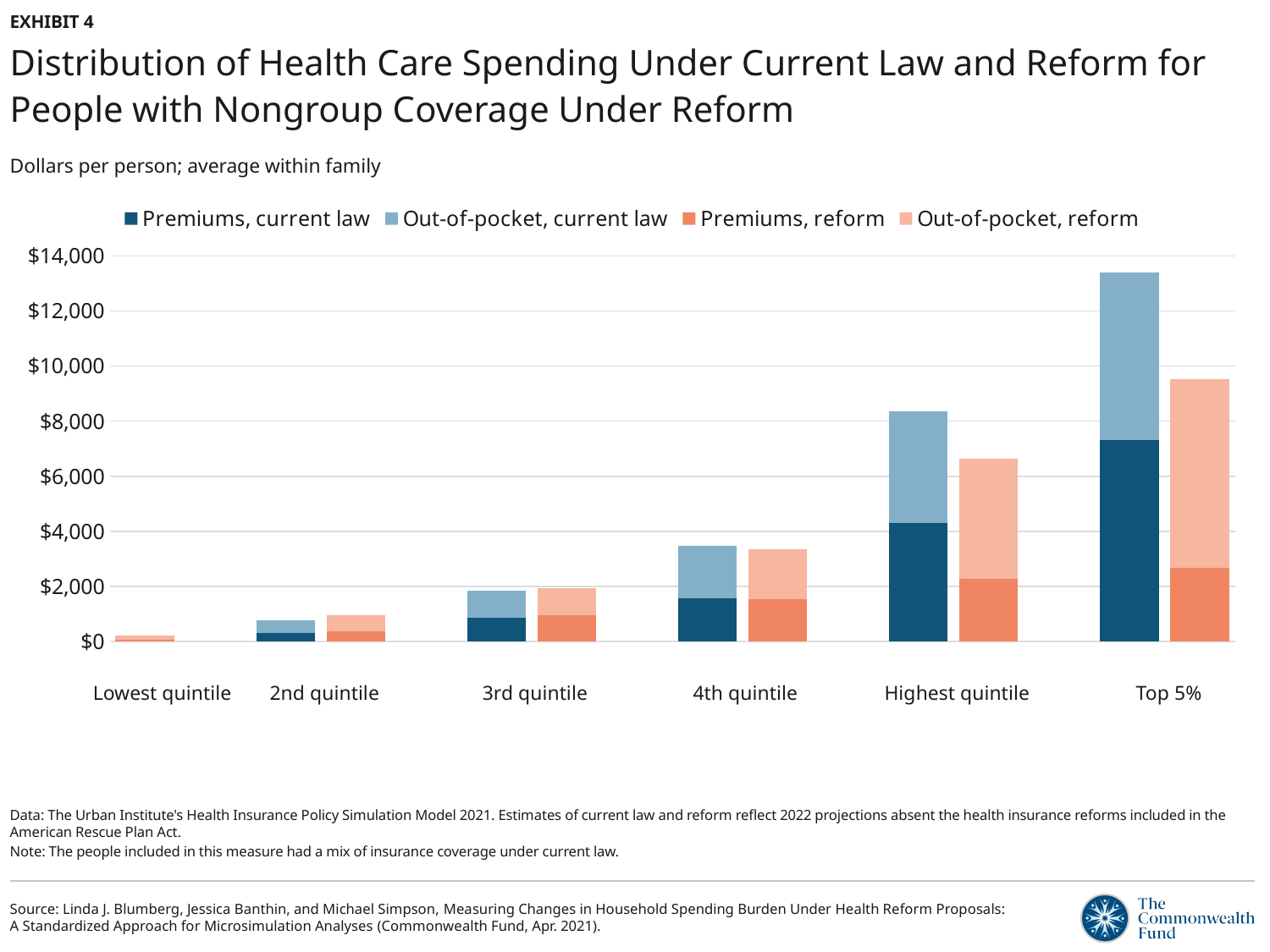
Is the total reform spending bar for Top 5% greater or less than $10,000? less How many series does the legend list? 4 For Top 5%, which is larger: premiums under current law or premiums under reform? Premiums, current law For the Highest quintile, which total is larger: current law or reform? Current law Is the total reform spending bar for the Highest quintile greater or less than $6,000? greater What kind of chart is shown on the slide? Stacked bar chart Which category has the tallest current-law (premiums plus out-of-pocket) bar? Top 5% How many income categories are shown on the x axis? 6 Is the total current-law spending bar for the 4th quintile greater or less than $4,000? less Do the total spending bars rise or fall moving from Lowest quintile to Top 5%? Rise